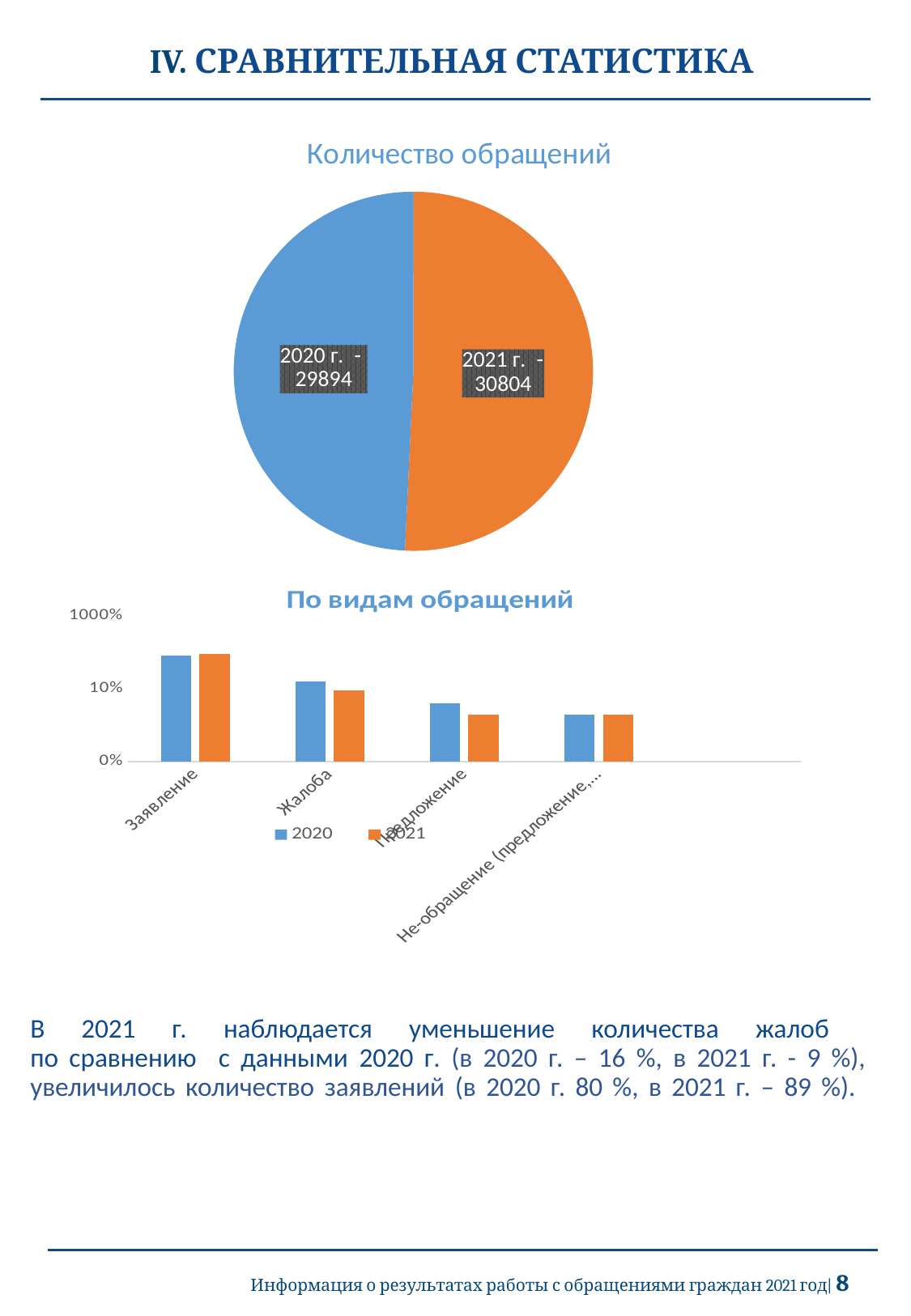
In the chart "По видам обращений", which category has the highest value for the 2020 series? Заявление How many slices does the pie chart "Количество обращений" have? 2 What kind of chart is the chart titled "Количество обращений"? pie chart In the pie chart "Количество обращений", which year has the larger value, 2020 г. or 2021 г.? 2021 г. How many series does the legend of the chart "По видам обращений" list? 2 In the pie chart "Количество обращений", what is the value for 2021 г.? 30804 In the chart "По видам обращений", is the 2020 value for Предложение greater or less than 10%? less What kind of chart is the chart titled "По видам обращений"? bar chart In the chart "По видам обращений", which series has the larger value for Жалоба, 2020 or 2021? 2020 In the pie chart "Количество обращений", what is the value for 2020 г.? 29894 How many categories are shown on the x axis of the chart "По видам обращений"? 4 In the pie chart "Количество обращений", what is the difference between the 2021 г. value and the 2020 г. value? 910